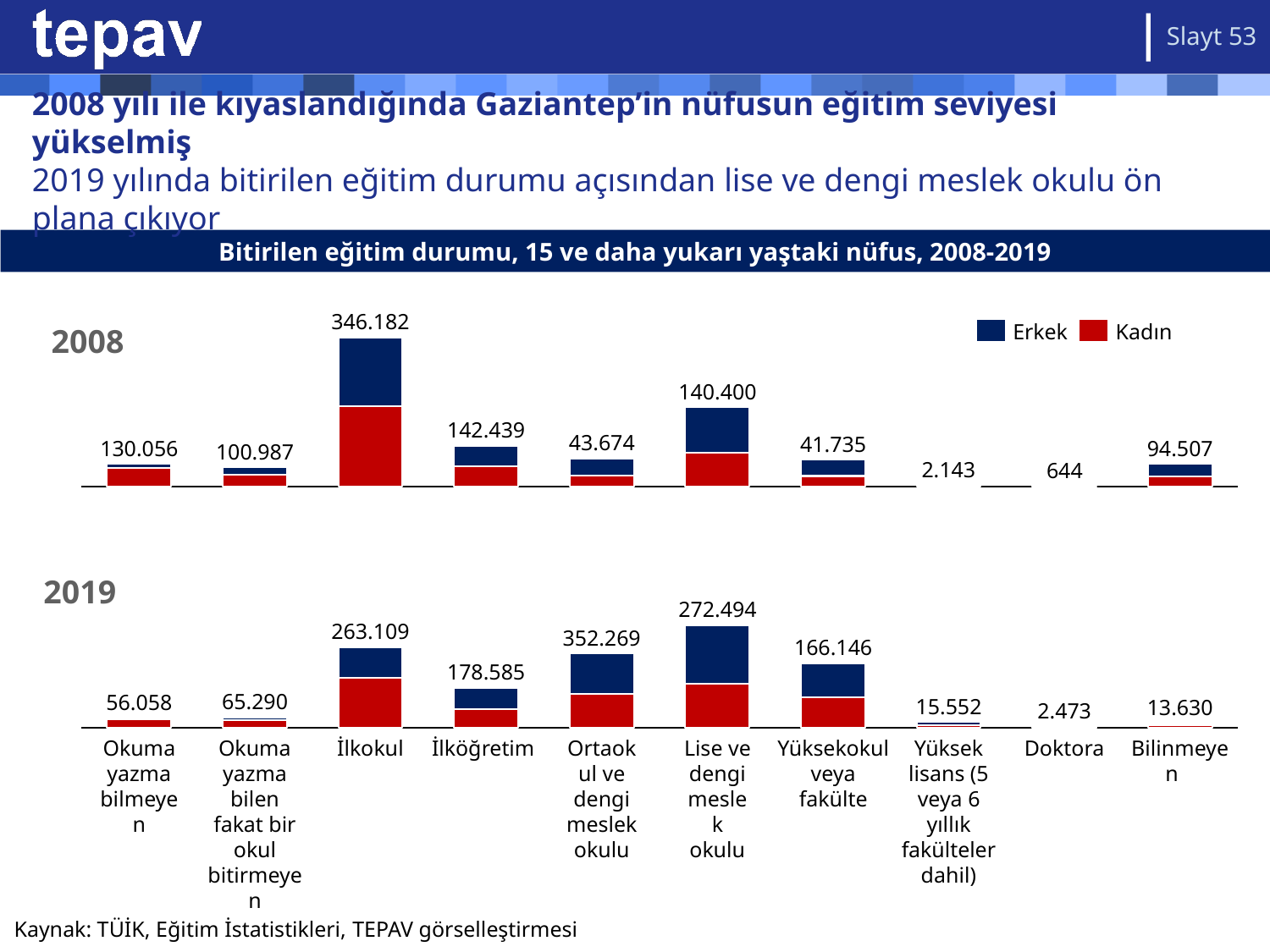
What is the difference between the 2019 total and the 2008 total for Lise ve dengi meslek okulu? 132.094 In the 2019 chart, what total value is shown for Ortaokul ve dengi meslek okulu? 352.269 In the 2008 chart, what total value is shown for İlkokul? 346.182 In the 2008 chart, which category has the highest total? İlkokul In the 2019 chart, what total value is shown for Yüksekokul veya fakülte? 166.146 What kind of chart is used to show the 2008 and 2019 data? Stacked bar chart In the 2008 chart, which category has the lowest total? Doktora Which is larger: the 2008 total for Okuma yazma bilmeyen or the 2019 total for Okuma yazma bilmeyen? 2008 (130.056) In the 2019 chart, which category has the lowest total? Doktora How many series does the legend list? 2 How many education categories are shown along the x axis? 10